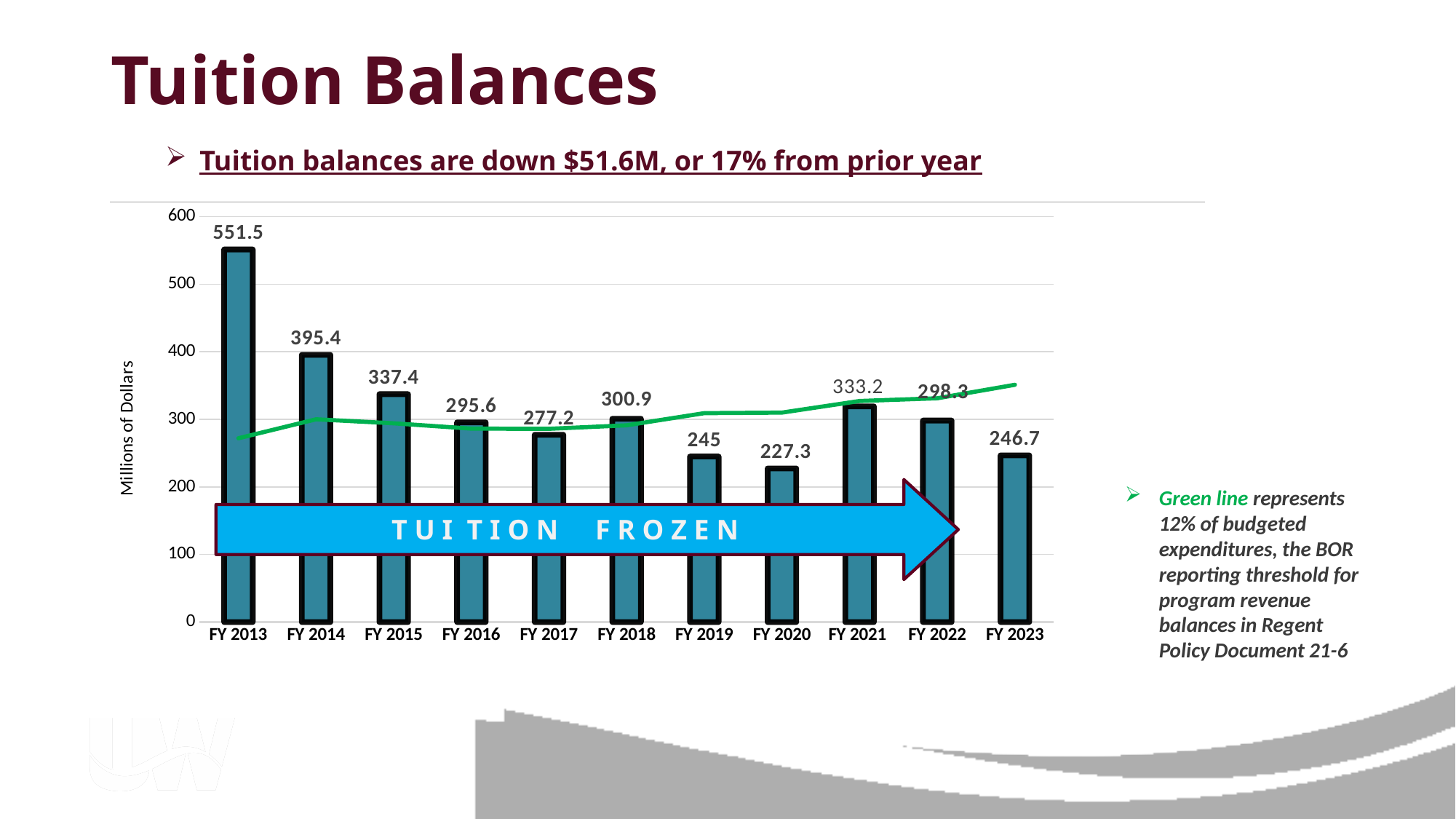
Which is larger, the tuition balance for FY 2018 or FY 2019? FY 2018 What is the difference between the tuition balances for FY 2022 and FY 2023? 51.6 What is the tuition balance for FY 2020? 227.3 What is the tuition balance for FY 2023? 246.7 Which fiscal year has the highest tuition balance? FY 2013 Which fiscal year has the lowest tuition balance? FY 2020 Do the tuition balances generally rise or fall from FY 2013 to FY 2017? fall What is the label on the vertical axis of the chart? Millions of Dollars Is the tuition balance for FY 2021 greater or less than 300? greater How many fiscal years are shown on the x axis of the chart? 11 What is the tuition balance for FY 2013? 551.5 What kind of chart is used to show the tuition balances? bar chart